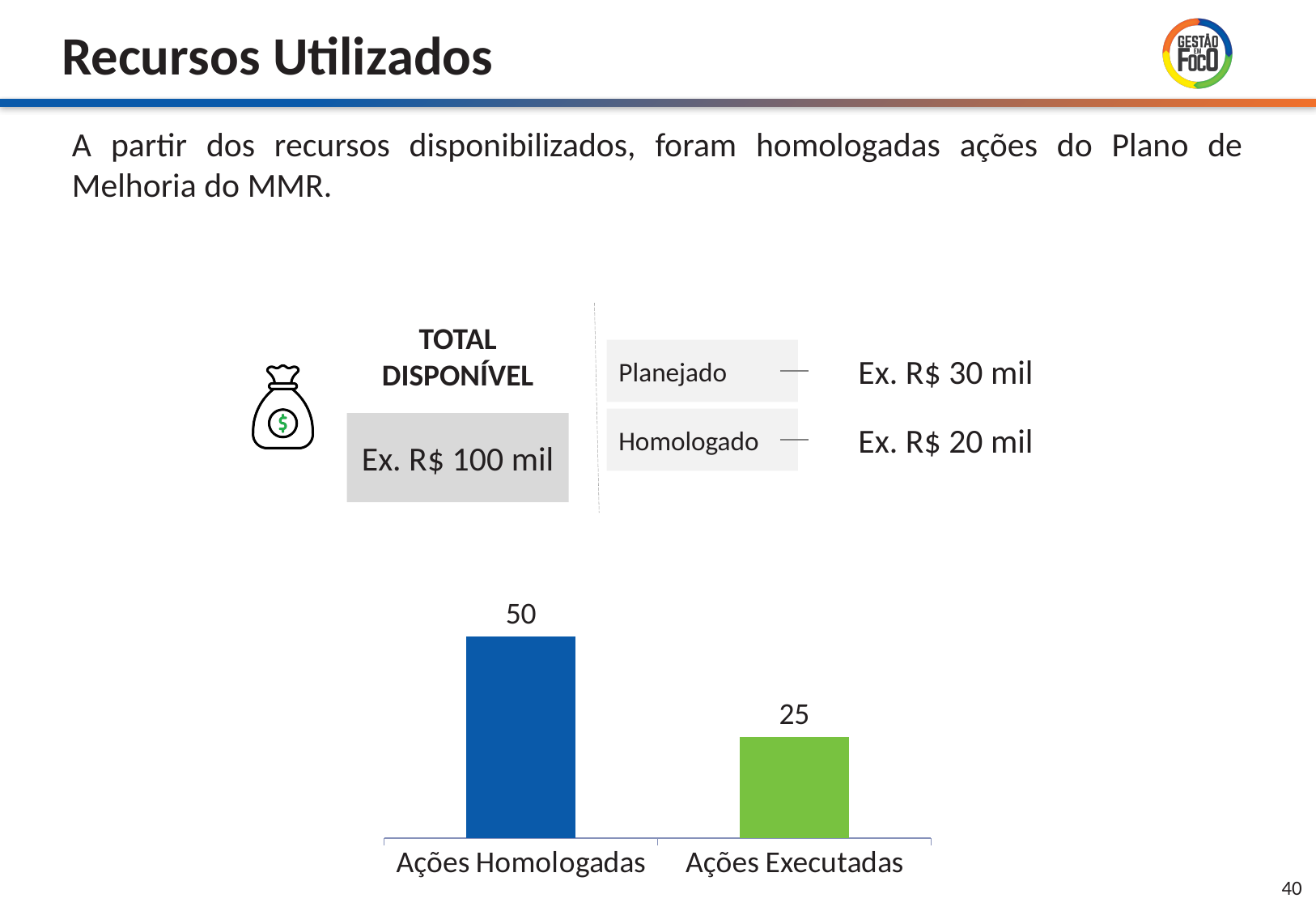
How many categories are shown in the bar chart? 2 What is the value for Ações Executadas in the bar chart? 25 What colour is the bar for Ações Homologadas? Blue What is the difference between the values for Ações Homologadas and Ações Executadas? 25 Which is larger, the value for Ações Homologadas or Ações Executadas? Ações Homologadas What kind of chart is shown on the slide? Bar chart Which category has the lowest value in the bar chart? Ações Executadas What colour is the bar for Ações Executadas? Green Do the values rise or fall from Ações Homologadas to Ações Executadas? Fall What is the value for Ações Homologadas in the bar chart? 50 Which category has the highest value in the bar chart? Ações Homologadas